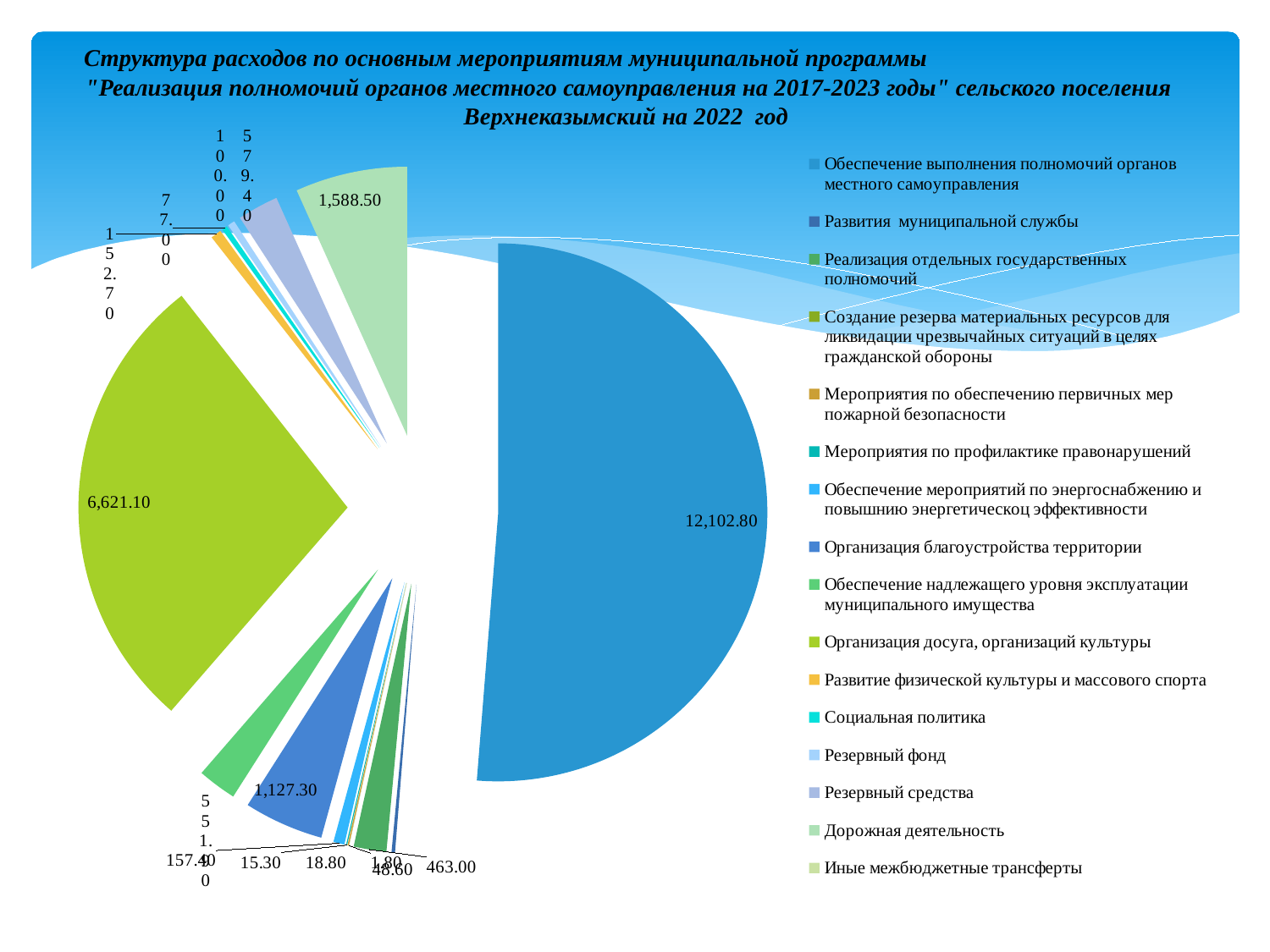
What is the difference between the value for Обеспечение выполнения полномочий органов местного самоуправления (12,102.80) and the value for Организация досуга, организаций культуры (6,621.10)? 5,481.70 What is the value for Организация досуга, организаций культуры? 6,621.10 How many categories does the legend of the pie chart list? 16 What is the value of the largest slice in the pie chart? 12,102.80 Which category has the largest slice in the pie chart? Обеспечение выполнения полномочий органов местного самоуправления What kind of chart is shown on the slide? pie chart What is the value for Дорожная деятельность? 1,588.50 What is the difference between the value for Дорожная деятельность (1,588.50) and the value for Организация благоустройства территории (1,127.30)? 461.20 Which settlement is named in the chart title? Верхнеказымский What is the value for Организация благоустройства территории? 1,127.30 Which is larger: the slice for Обеспечение выполнения полномочий органов местного самоуправления or the slice for Организация досуга, организаций культуры? Обеспечение выполнения полномочий органов местного самоуправления Which year does the chart title say the expenditure structure is for? 2022